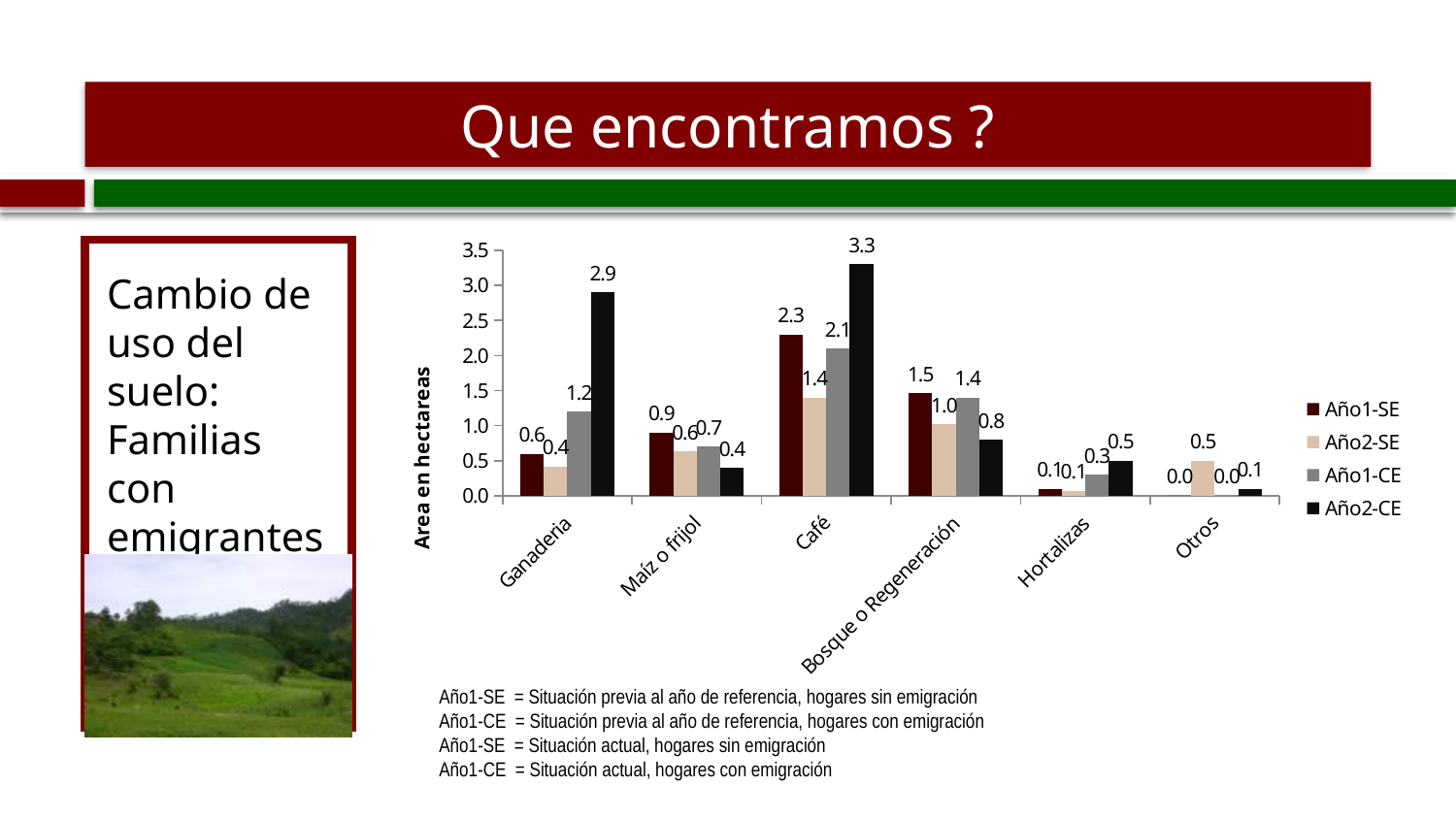
What is the value for Año2-SE in the Otros category? 0.5 What is the difference between the Año2-CE and Año1-SE values for Ganaderia? 2.3 What is the label of the y axis? Area en hectareas Is the Año2-CE value for Café greater or less than 3.0? greater What is the value for Año2-CE in the Café category? 3.3 How many categories are shown on the x axis? 6 What kind of chart is shown on the slide? bar chart Which category has the lowest Año1-SE value? Otros How many series does the legend list? 4 Which is larger for Bosque o Regeneración: Año1-SE or Año2-CE? Año1-SE Which category has the highest Año2-CE value? Café What is the value for Año1-CE in the Ganaderia category? 1.2